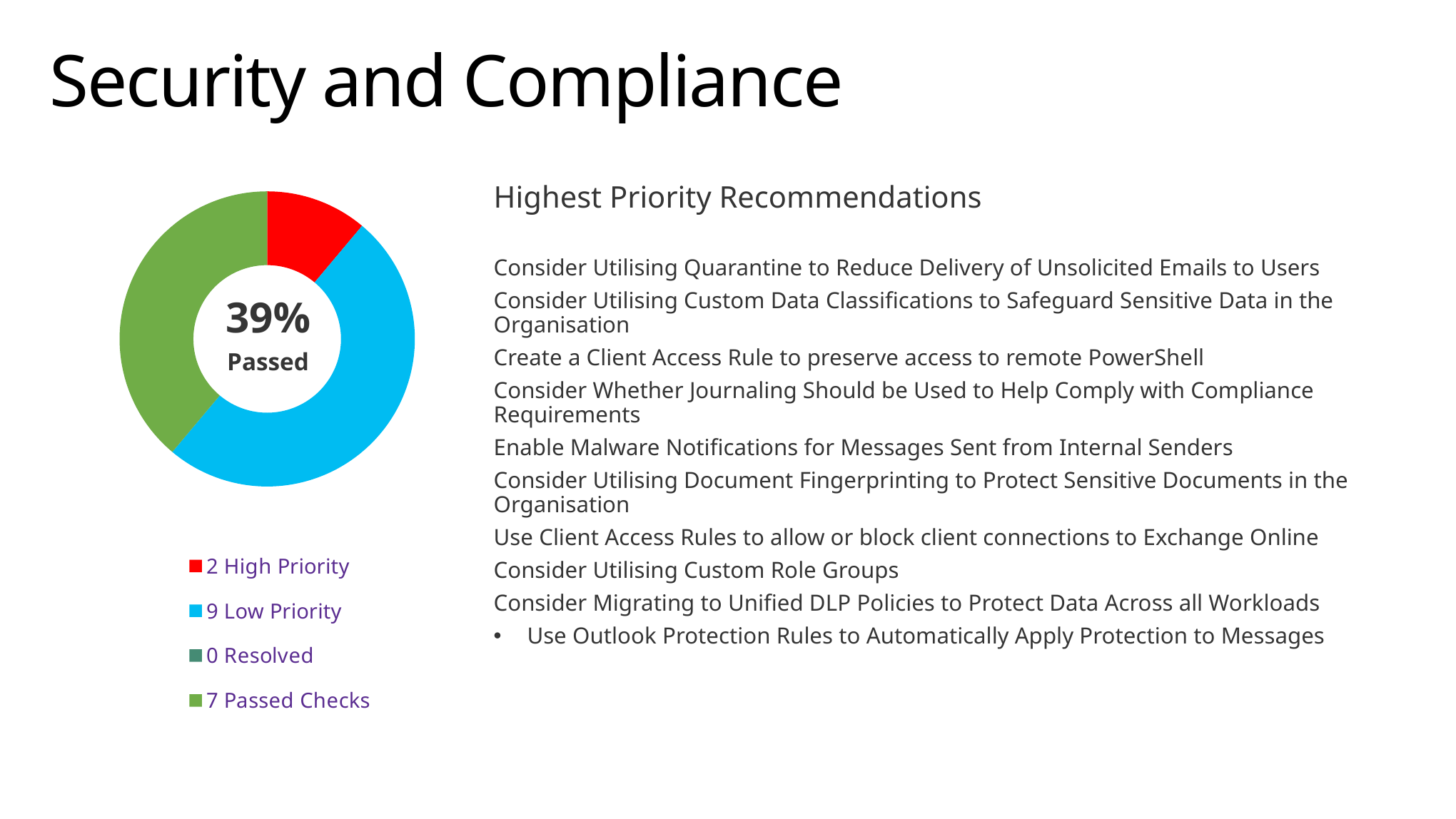
What percentage of checks passed, according to the text in the centre of the chart? 39% How many High Priority items does the chart legend show? 2 What kind of chart is shown on the slide? doughnut chart How many categories does the chart legend list? 4 Which category has the smallest value in the chart? Resolved How many Resolved items does the chart legend show? 0 Which category has the largest value in the chart? Low Priority What is the difference between the number of Low Priority items and the number of High Priority items? 7 How many Low Priority items does the chart legend show? 9 How many Passed Checks does the chart legend show? 7 Which is larger, the number of Passed Checks or the number of High Priority items? Passed Checks What colour represents Low Priority in the chart? blue